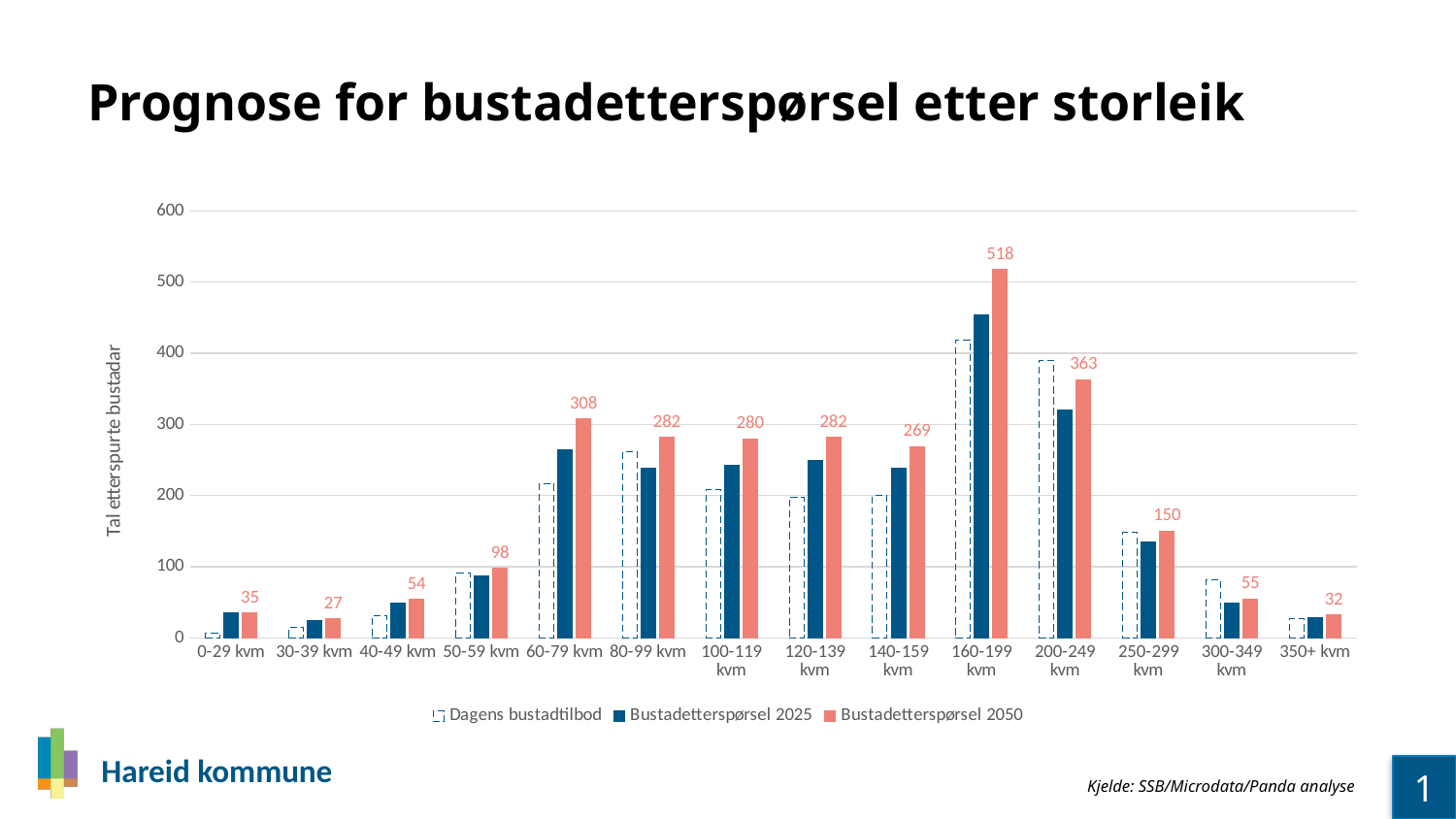
Is the Dagens bustadtilbod value for 200-249 kvm greater or less than 300? greater How many series does the legend list? 3 What is the Bustadetterspørsel 2050 value for the 60-79 kvm category? 308 Is the Bustadetterspørsel 2025 value for 160-199 kvm greater or less than 400? greater What is the Bustadetterspørsel 2050 value for the 160-199 kvm category? 518 How many size categories are shown on the x axis? 14 Which category has the lowest Bustadetterspørsel 2050 value? 30-39 kvm What is the title of the vertical axis? Tal etterspurte bustadar Which category has the highest Bustadetterspørsel 2050 value? 160-199 kvm What kind of chart is shown on the slide? bar chart What is the difference between the Bustadetterspørsel 2050 values for 160-199 kvm and 200-249 kvm? 155 Which has the larger Bustadetterspørsel 2050 value: 60-79 kvm or 80-99 kvm? 60-79 kvm